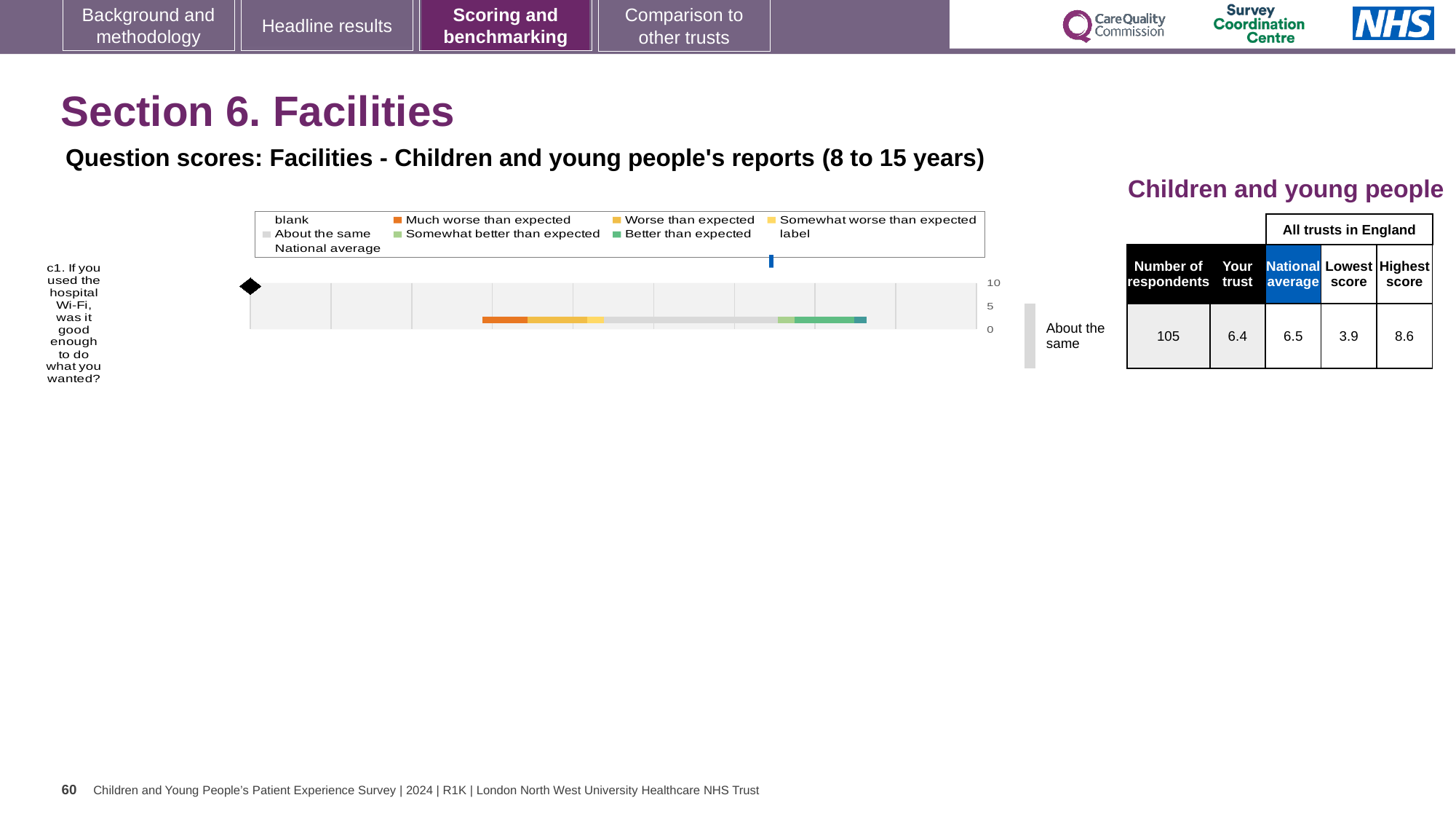
What is the lowest score among all trusts in England for question c1? 3.9 How many survey questions are plotted in the chart on this slide? 1 According to the table, what is the national average score for question c1? 6.5 What is the highest score among all trusts in England for question c1? 8.6 What kind of chart is shown on the slide for question c1? bar chart According to the table, what is the 'Your trust' score for question c1 about hospital Wi-Fi? 6.4 How many respondents answered question c1? 105 What benchmark category is the trust's score for question c1 placed in? About the same Which legend entry is shown in orange in the chart legend? Much worse than expected What is the difference between the highest score and the lowest score for question c1? 4.7 What is the highest value shown on the chart's axis? 10 Which is larger for question c1: the trust's score or the national average? national average